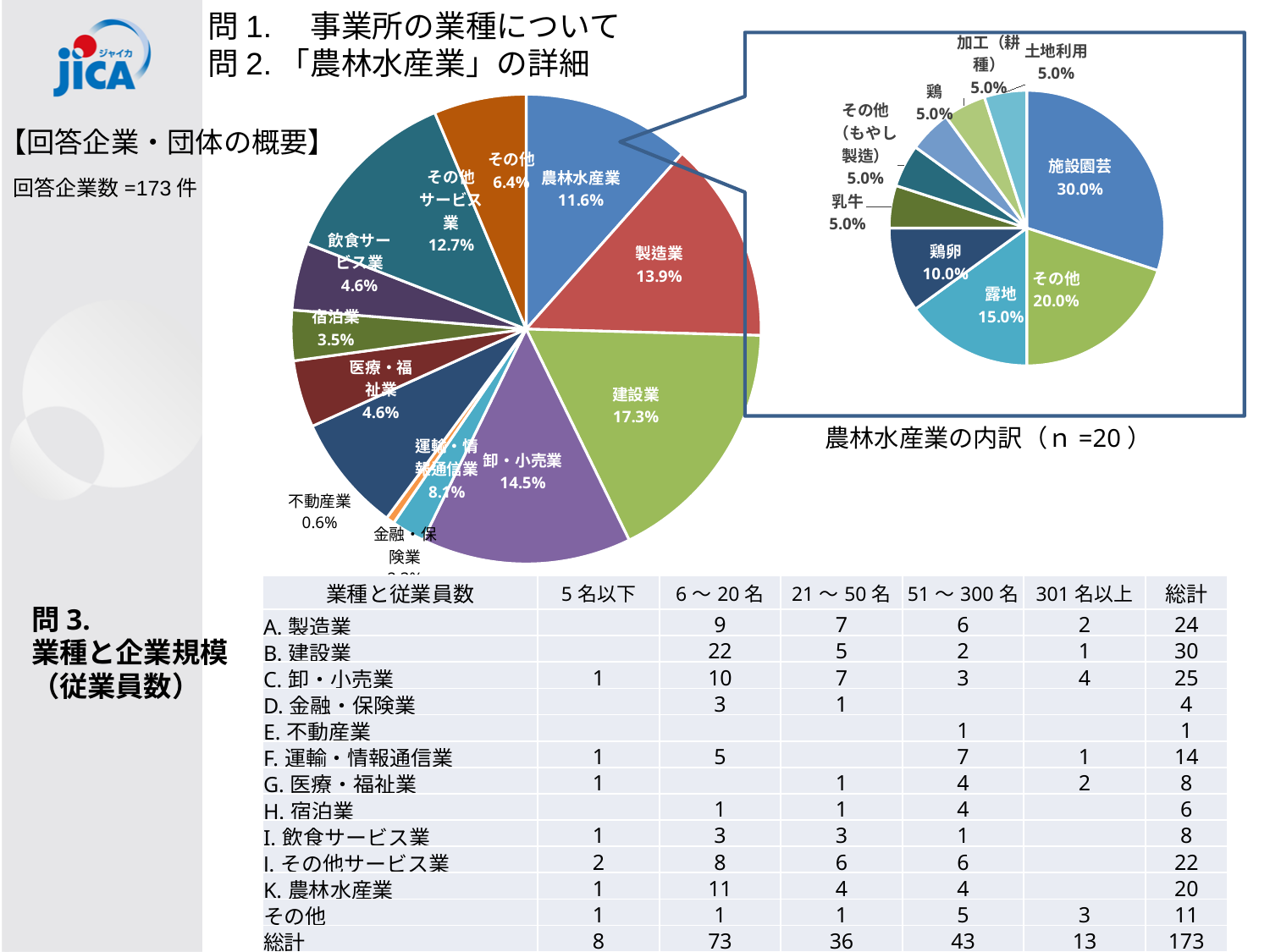
In the large pie chart on the left (事業所の業種), which category has the largest share? 建設業 In the large pie chart on the left (事業所の業種), what share is 農林水産業? 11.6% In the large pie chart on the left (事業所の業種), what share is 建設業? 17.3% In the small pie chart on the right (農林水産業の内訳), what share is 施設園芸? 30.0% In the small pie chart on the right (農林水産業の内訳), which category has the largest share? 施設園芸 In the large pie chart on the left (事業所の業種), which category has the smallest share? 不動産業 How many slices does the small pie chart on the right (農林水産業の内訳) have? 9 In the small pie chart on the right (農林水産業の内訳), what share is 露地? 15.0% In the small pie chart on the right (農林水産業の内訳), what is the difference between the shares of 施設園芸 and 鶏卵? 20.0% In the large pie chart on the left (事業所の業種), which is larger: 卸・小売業 or 製造業? 卸・小売業 What type of chart is used for 農林水産業の内訳 on the right of the slide? Pie chart In the large pie chart on the left (事業所の業種), what is the difference between the shares of 建設業 and 製造業? 3.4%